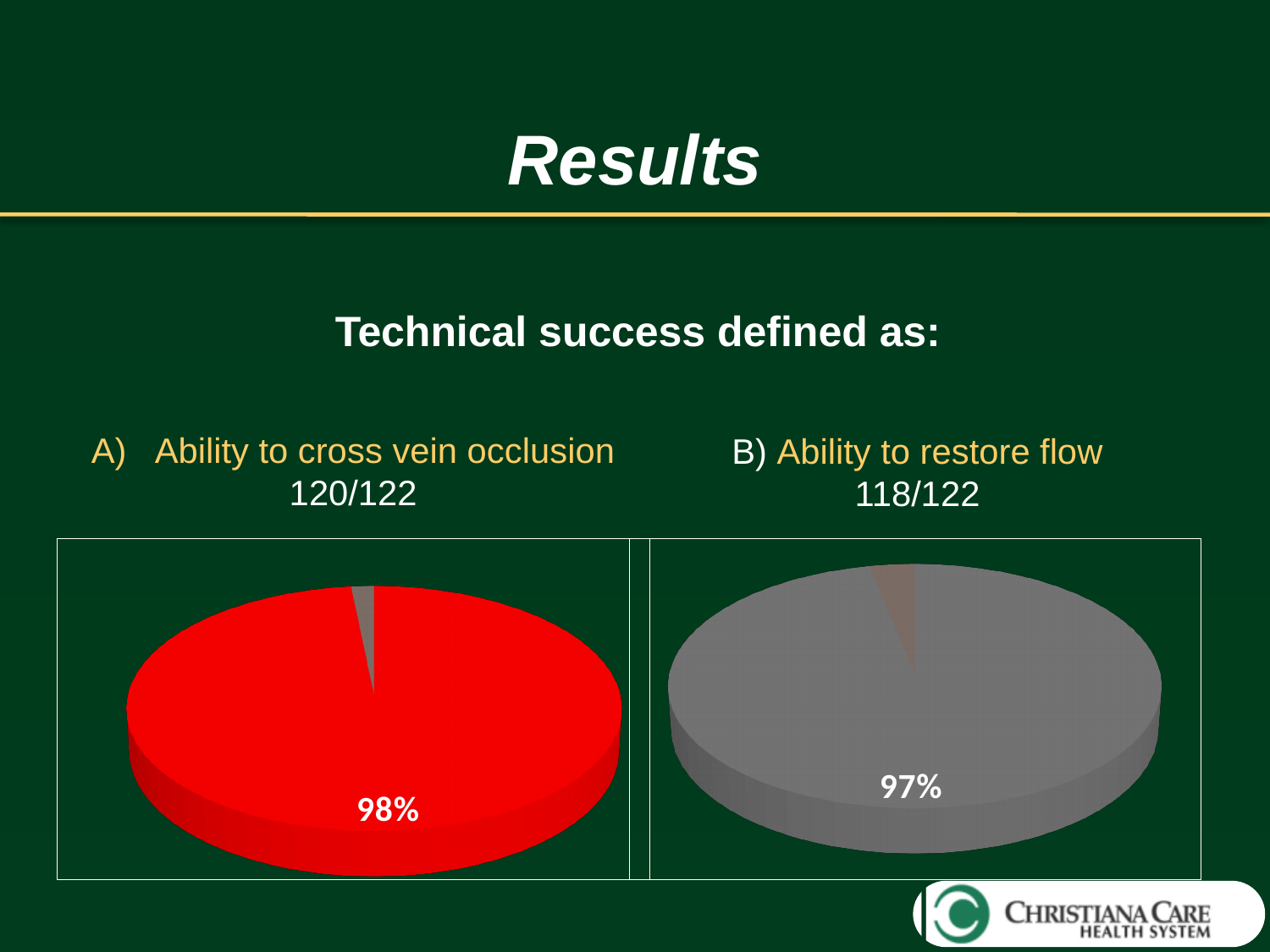
What kind of chart is shown on the left side of the slide, under 'Ability to cross vein occlusion'? Pie chart In the right pie chart (Ability to restore flow), what percentage is printed on the large slice? 97% How many pie charts are shown on the slide? 2 What is the difference in percentage points between the labelled share in the left pie chart (98%) and the labelled share in the right pie chart (97%)? 1 percentage point What colour is the large slice in the left pie chart (Ability to cross vein occlusion)? Red Which pie chart shows the larger labelled share: the left one (Ability to cross vein occlusion) or the right one (Ability to restore flow)? The left one (Ability to cross vein occlusion) In the left pie chart (Ability to cross vein occlusion), what percentage is printed on the large slice? 98% How many slices does the left pie chart (Ability to cross vein occlusion) have? 2 What kind of chart is shown on the right side of the slide, under 'Ability to restore flow'? Pie chart In the left pie chart (Ability to cross vein occlusion), is the large slice the majority or the minority of the pie? Majority What colour is the large slice in the right pie chart (Ability to restore flow)? Grey How many slices does the right pie chart (Ability to restore flow) have? 2